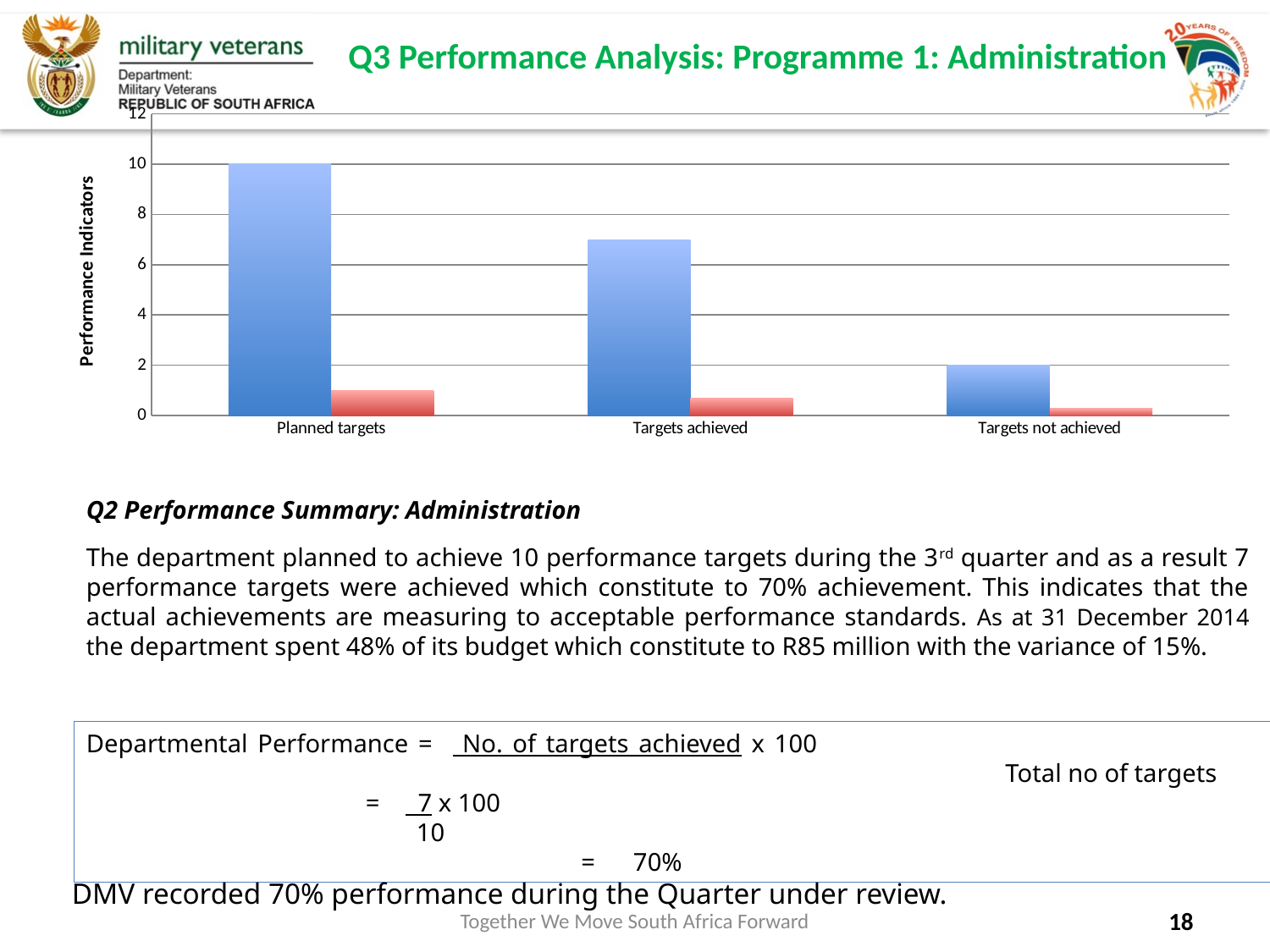
What is the highest value shown on the vertical axis of the chart? 12 What is the difference between the blue bars for Planned targets and Targets not achieved? 8 Is the red bar for Planned targets greater or less than 2? less What kind of chart is shown on the slide? bar chart What is the value of the blue bar for Targets not achieved? 2 Which category has the tallest blue bar? Planned targets Which has the larger blue bar, Targets achieved or Targets not achieved? Targets achieved Which category has the shortest blue bar? Targets not achieved Is the blue bar for Targets achieved greater or less than 6? greater How many categories are shown on the x axis of the chart? 3 What is the value of the blue bar for Planned targets? 10 What is the label on the vertical axis of the chart? Performance Indicators